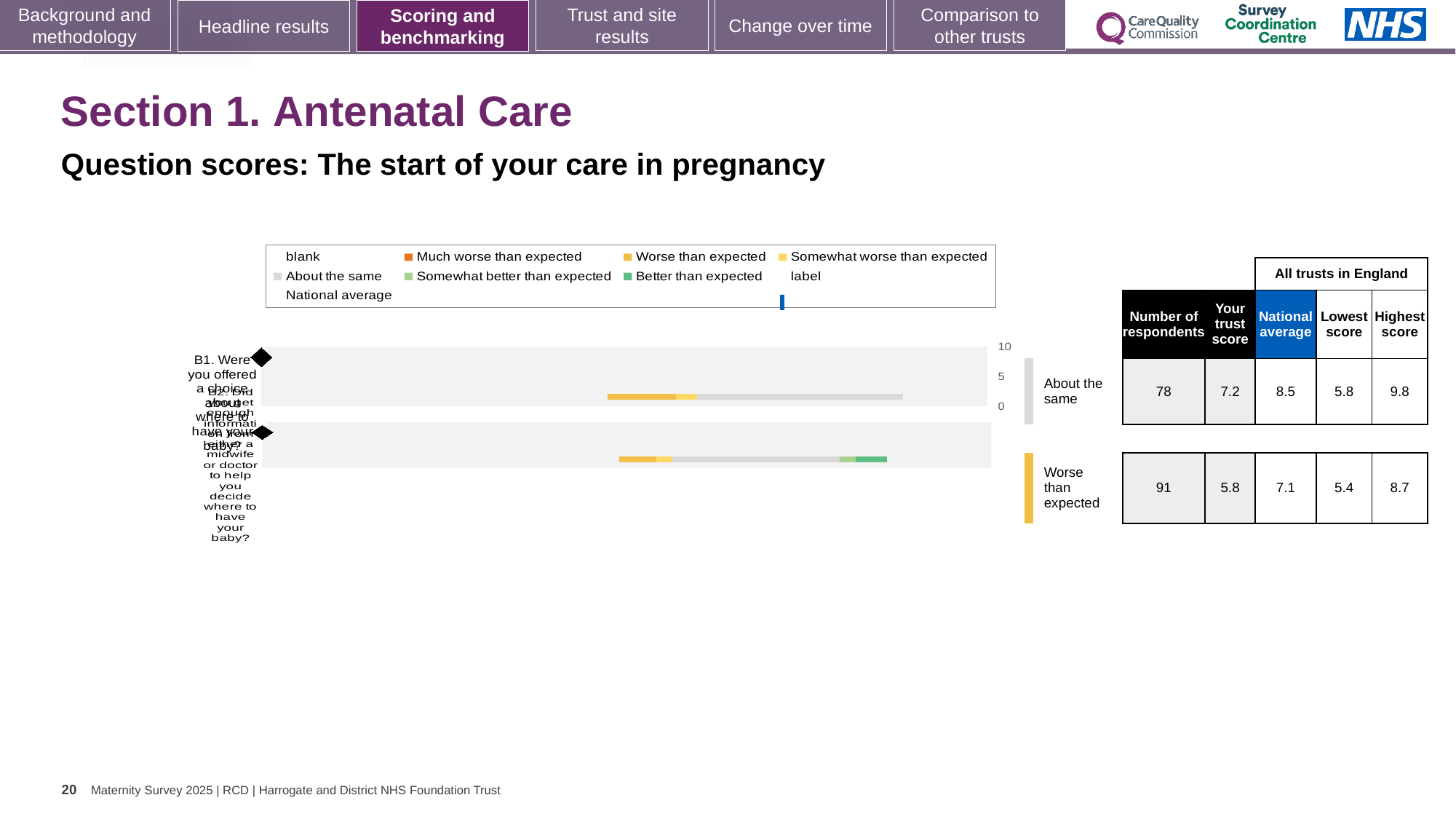
What is the national average score for question B1? 8.5 What is the highest score among all trusts in England for question B1? 9.8 Which question has the higher trust score, B1 or B2? B1 How many respondents answered question B2? 91 What is the difference between the national average and the trust score for question B1? 1.3 How many survey questions are plotted in the chart? 2 What is the lowest score among all trusts in England for question B2? 5.4 What is the trust score for question B1 (Were you offered a choice about where to have your baby)? 7.2 What kind of chart is shown on the slide? bar chart What is the maximum value shown on the score axis of the chart? 10 Which benchmark category is question B2 placed in? Worse than expected What is the trust score for question B2? 5.8